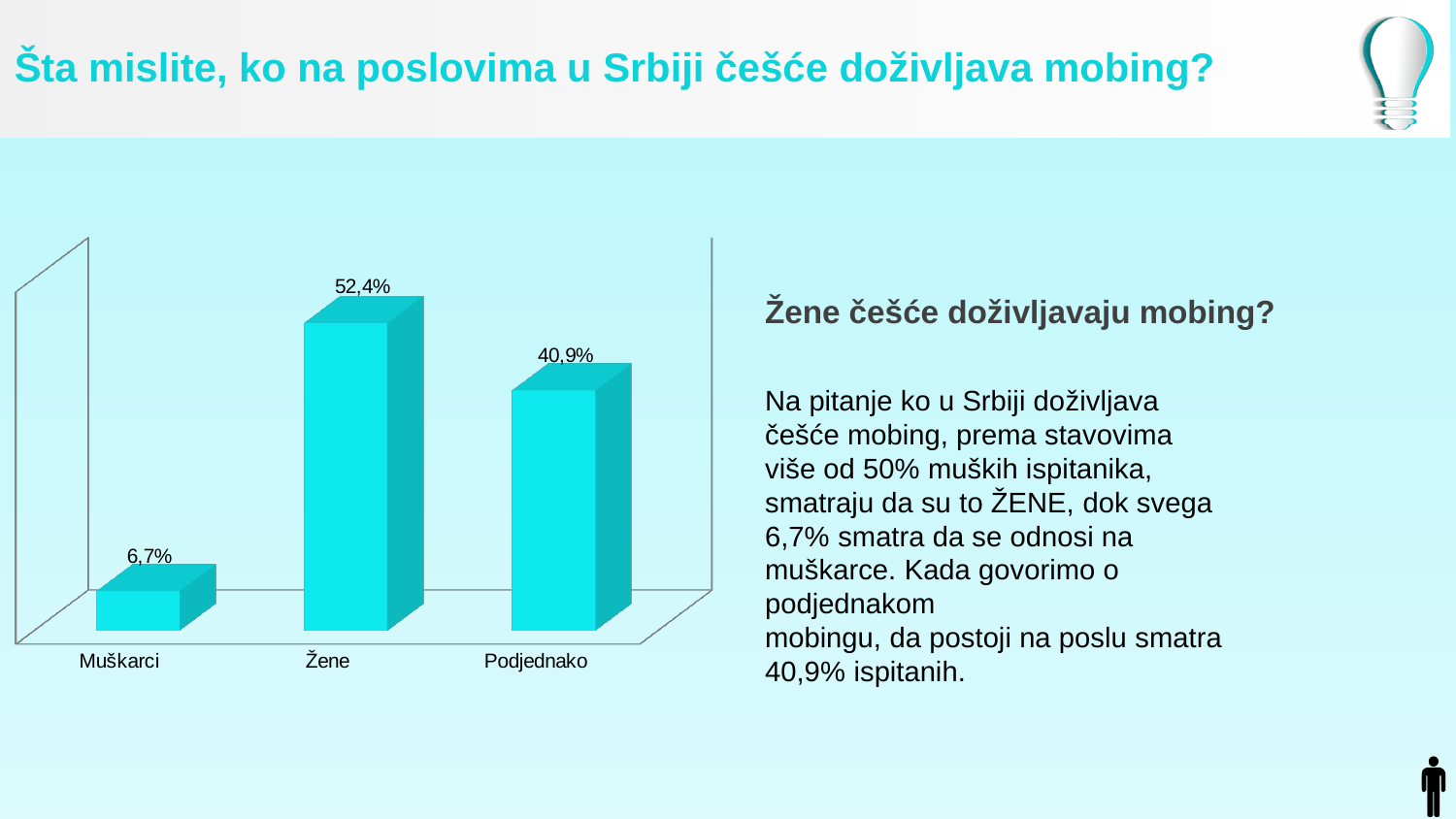
What is the value for Muškarci? 6,7% Which category has the lowest value? Muškarci What is the difference between the values for Podjednako and Muškarci? 34,2% What kind of chart is shown on the slide? Bar chart What is the value for Podjednako? 40,9% Which is larger, the value for Žene or the value for Podjednako? Žene Which category has the highest value? Žene What is the value for Žene? 52,4% What is the label of the middle bar in the chart? Žene How many categories are shown in the chart? 3 What colour are the bars in the chart? Cyan What is the difference between the values for Žene and Podjednako? 11,5%